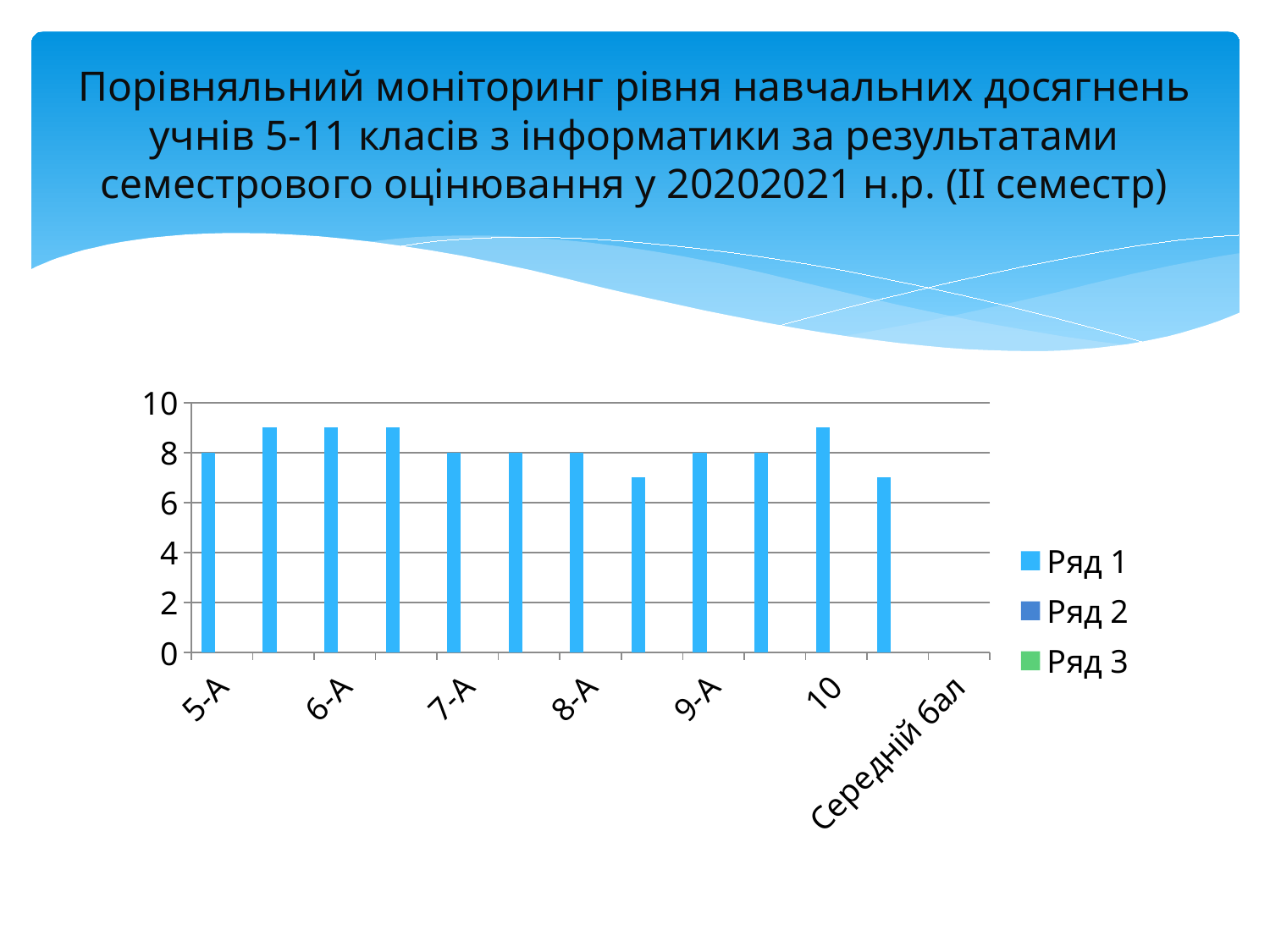
What is the value for 8-А? 8 Is the value for 6-А greater or less than 8? greater Is the value for 10 greater or less than 8? greater Which is larger, the value for 6-А or the value for 5-А? 6-А What type of chart is shown on the slide? bar chart What is the value for 7-А? 8 How many series does the legend list? 3 Which is larger, the value for 10 or the value for 9-А? 10 What is the highest value shown on the vertical axis? 10 What is the name of the first series in the legend? Ряд 1 What is the value for 9-А? 8 What is the value for 5-А? 8